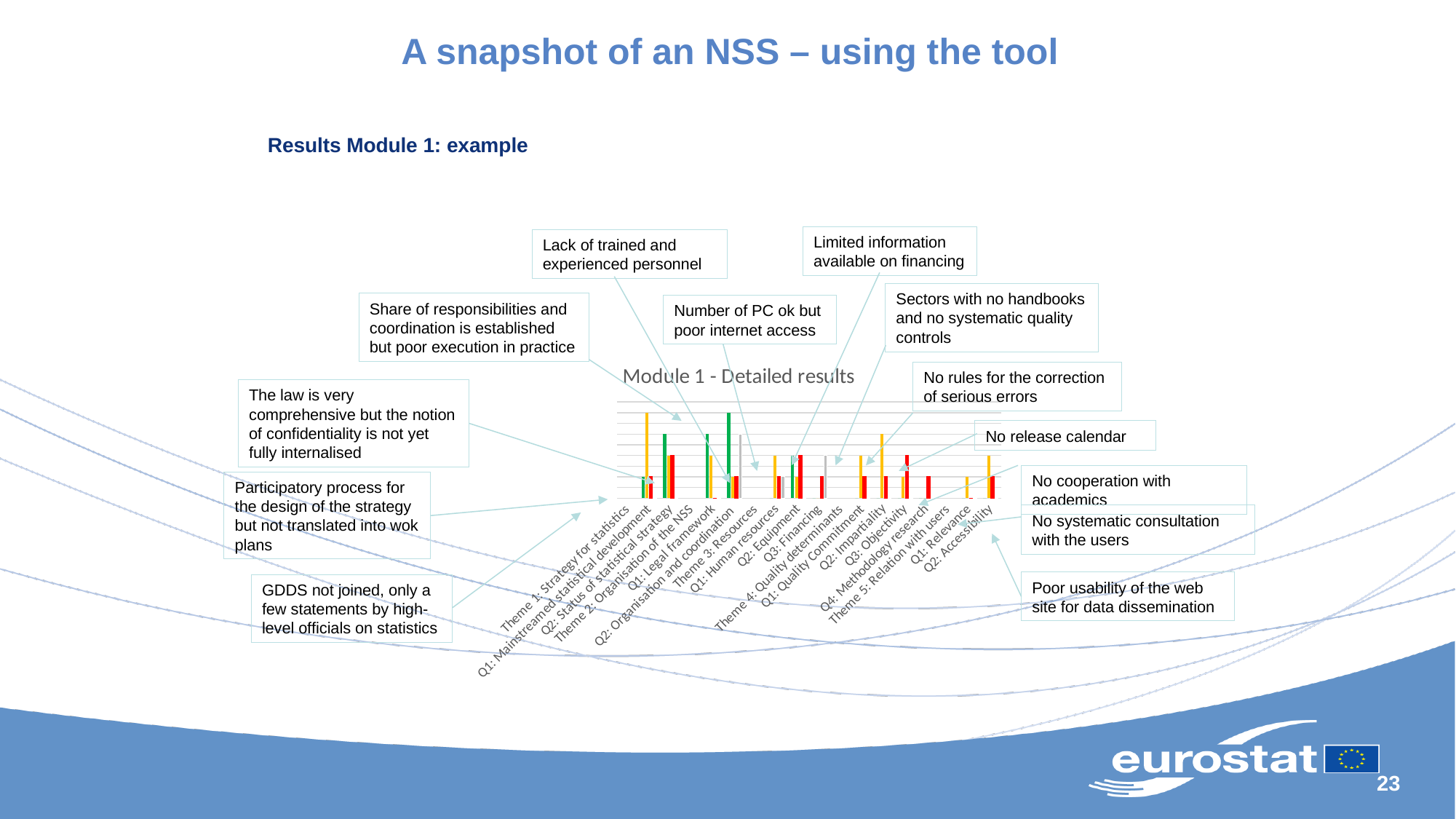
In the 'Q1: Legal framework' group, which colour bar is the tallest? Green What kind of chart is shown under the heading 'Module 1 - Detailed results'? Bar chart In the 'Q2: Organisation and coordination' group, which colour bar is the tallest? Green In the 'Q1: Mainstreamed statistical development' group, which colour bar is the tallest? Yellow Which colours are used for the bars in the chart? Green, yellow, red and grey How many categories are listed along the x axis of the chart? 18 What is the title of the chart on the slide? Module 1 - Detailed results